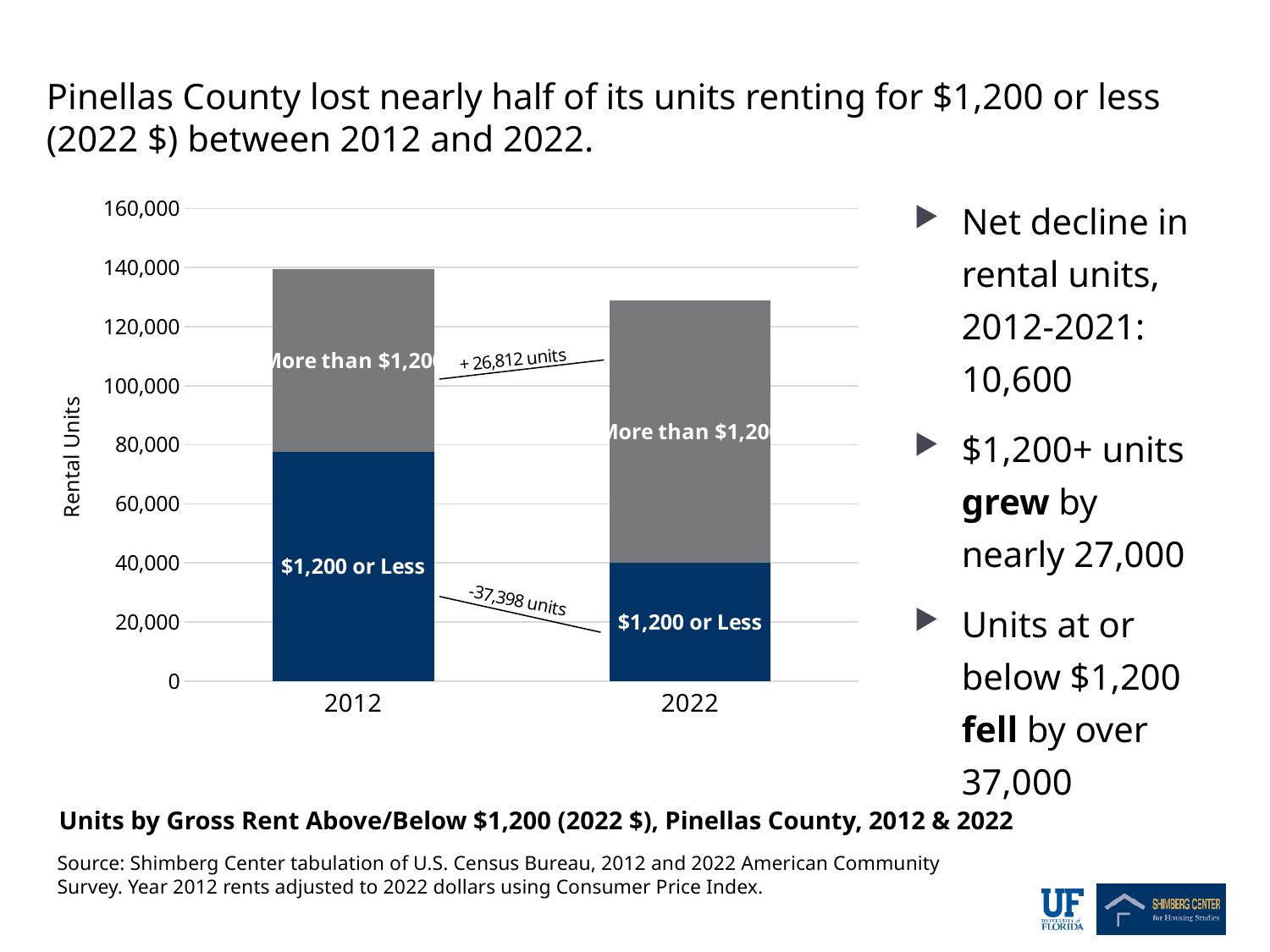
In 2022, which segment is larger: '$1,200 or Less' or 'More than $1,200'? More than $1,200 Is the total number of rental units in 2022 greater or less than 140,000? less Which year has more '$1,200 or Less' rental units, 2012 or 2022? 2012 According to the annotation on the chart, by how many units did the '$1,200 or Less' segment change between 2012 and 2022? -37,398 units Is the number of '$1,200 or Less' rental units in 2012 greater or less than 60,000? greater What kind of chart is shown on the slide? stacked bar chart How many rent segments make up each stacked bar in the chart? 2 What is the label on the vertical axis of the chart? Rental Units Is the total number of rental units in 2012 greater or less than 120,000? greater According to the annotation on the chart, by how many units did the 'More than $1,200' segment change between 2012 and 2022? +26,812 units How many years (categories) are shown on the x axis of the chart? 2